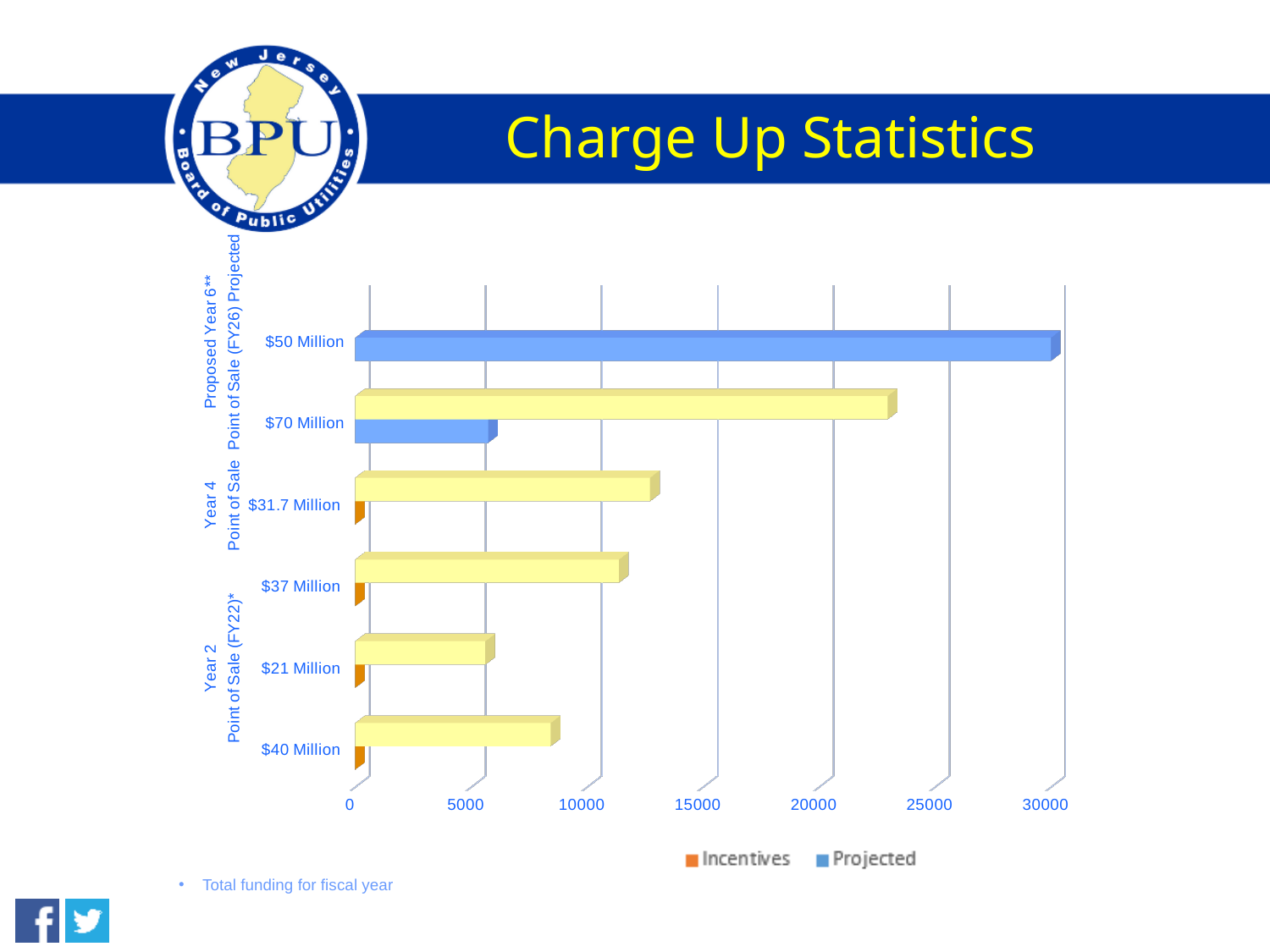
How many series does the chart legend list? 2 Is the Projected value for $50 Million greater or less than 25000? greater Which has the longer yellow bar, $21 Million or $40 Million? $40 Million What are the two entries in the chart legend? Incentives, Projected Which category has the longest bar in the chart? $50 Million Is the yellow bar for $70 Million greater or less than 20000? greater Is the yellow bar for $40 Million greater or less than 10000? less Which has the longer yellow bar, $70 Million or $37 Million? $70 Million What kind of chart is shown on the slide? bar chart How many funding categories are shown on the vertical axis of the chart? 6 What is the title of the slide containing the chart? Charge Up Statistics